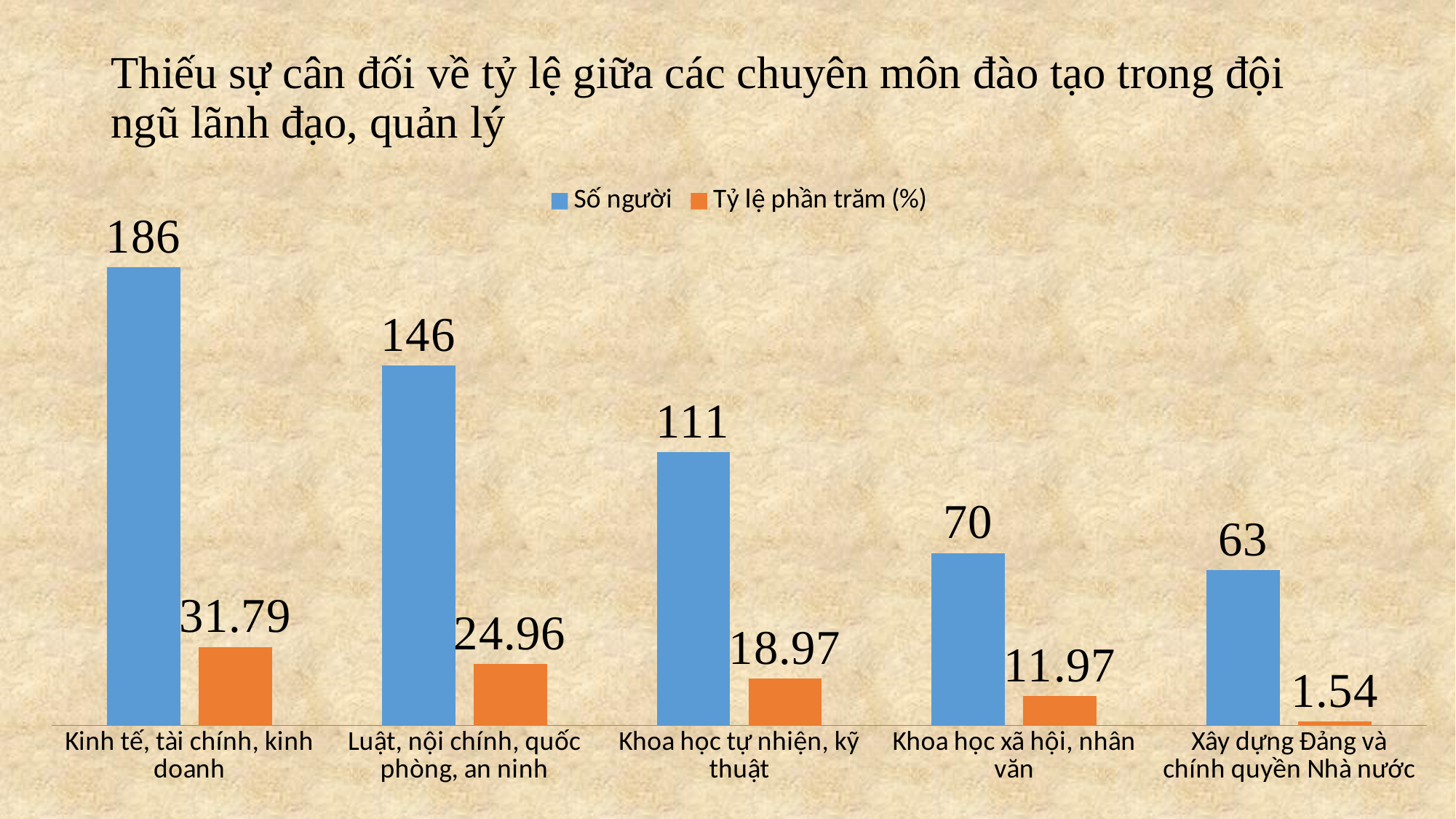
How many categories are shown on the x axis? 5 How many series does the legend list? 2 Do the 'Số người' values rise or fall from left to right along the x axis? Fall Which category has the highest 'Số người' value? Kinh tế, tài chính, kinh doanh What is the 'Số người' value for 'Xây dựng Đảng và chính quyền Nhà nước'? 63 What is the difference in 'Số người' between 'Kinh tế, tài chính, kinh doanh' and 'Luật, nội chính, quốc phòng, an ninh'? 40 Which category has the lowest 'Tỷ lệ phần trăm (%)' value? Xây dựng Đảng và chính quyền Nhà nước What is the 'Số người' value for 'Kinh tế, tài chính, kinh doanh'? 186 What is the difference in 'Tỷ lệ phần trăm (%)' between 'Luật, nội chính, quốc phòng, an ninh' and 'Khoa học xã hội, nhân văn'? 12.99 Which has a larger 'Số người' value: 'Khoa học tự nhiên, kỹ thuật' or 'Khoa học xã hội, nhân văn'? Khoa học tự nhiên, kỹ thuật What is the 'Tỷ lệ phần trăm (%)' value for 'Khoa học tự nhiên, kỹ thuật'? 18.97 What kind of chart is shown on the slide? Bar chart